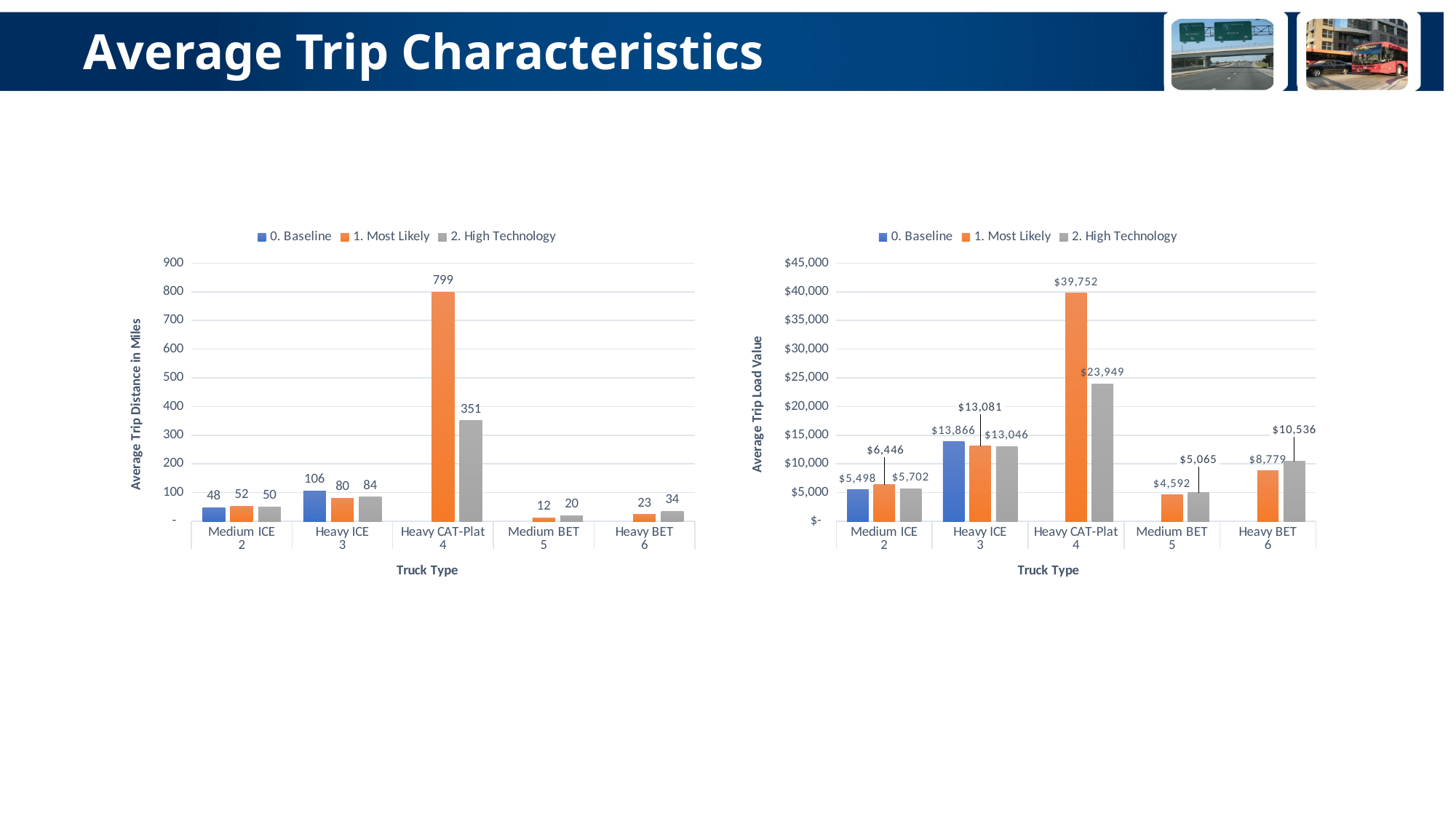
In the right chart (Average Trip Load Value), what is the 2. High Technology value for Heavy BET 6? $10,536 In the right chart (Average Trip Load Value), what is the difference between the 2. High Technology and 1. Most Likely values for Medium BET 5? $473 How many truck type categories are shown on the x axis of the left chart (Average Trip Distance in Miles)? 5 In the left chart (Average Trip Distance in Miles), what is the 0. Baseline value for Heavy ICE 3? 106 In the left chart (Average Trip Distance in Miles), which truck type has the highest value in the 2. High Technology series? Heavy CAT-Plat 4 How many series does the legend of the right chart (Average Trip Load Value) list? 3 In the left chart (Average Trip Distance in Miles), which truck type has the lowest value in the 1. Most Likely series? Medium BET 5 In the right chart (Average Trip Load Value), which is larger for Heavy ICE 3: the 0. Baseline value or the 1. Most Likely value? 0. Baseline In the left chart (Average Trip Distance in Miles), what is the difference between the 1. Most Likely and 2. High Technology values for Heavy CAT-Plat 4? 448 What kind of chart is the right chart (Average Trip Load Value)? Bar chart In the left chart (Average Trip Distance in Miles), what is the value for Heavy CAT-Plat 4 in the 1. Most Likely series? 799 In the right chart (Average Trip Load Value), what is the 1. Most Likely value for Heavy CAT-Plat 4? $39,752